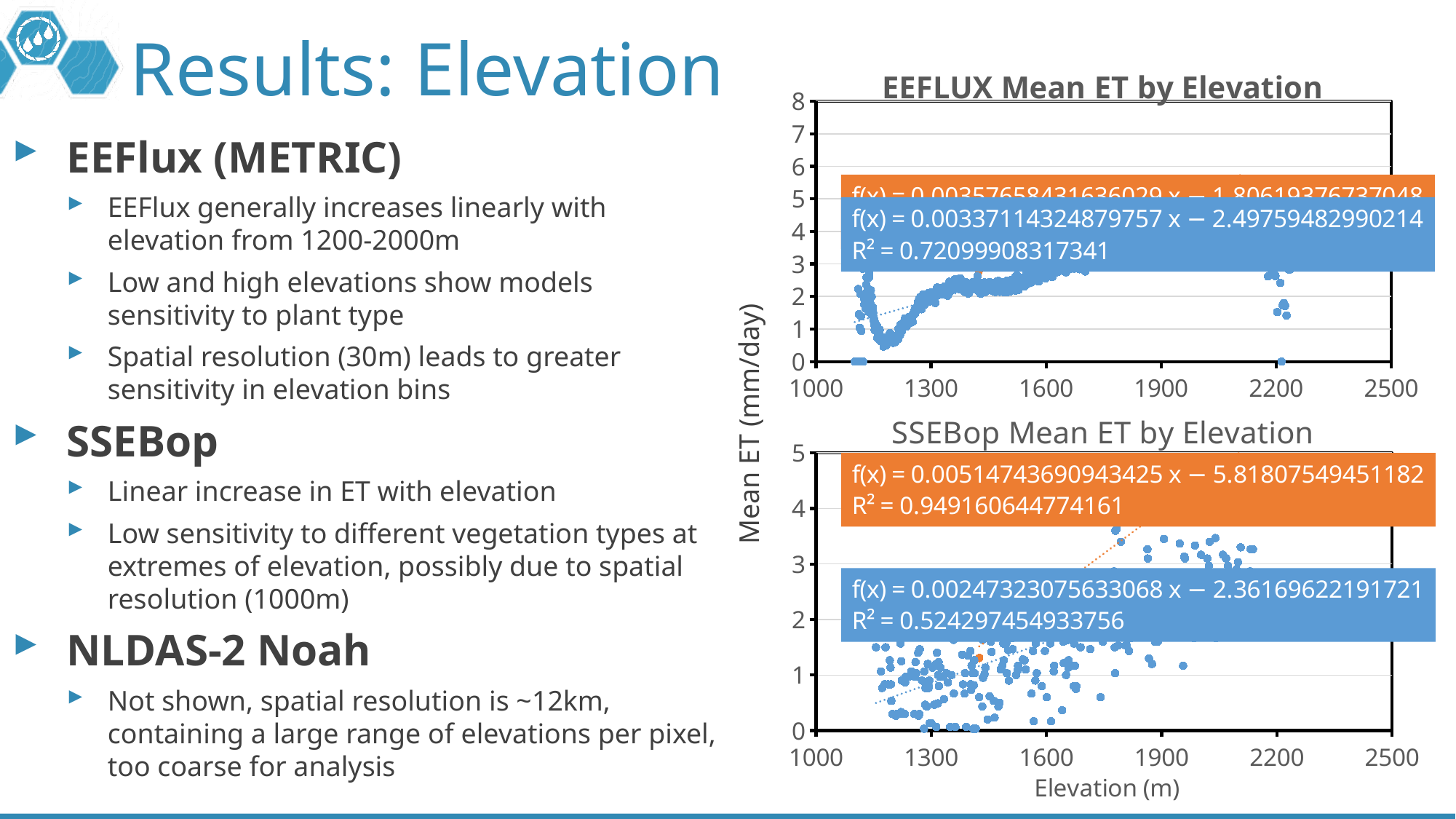
In the EEFLUX Mean ET by Elevation chart, what is the maximum value shown on the y-axis? 8 In the SSEBop Mean ET by Elevation chart, are the points plotted around 1900 m elevation greater or less than 2 mm/day? greater What kind of chart is the EEFLUX Mean ET by Elevation chart? Scatter chart In the EEFLUX Mean ET by Elevation chart, what is the R² value shown in the blue box? 0.72099908317341 What is the title of the lower chart on the slide? SSEBop Mean ET by Elevation In the SSEBop Mean ET by Elevation chart, what is the R² value shown in the blue box? 0.524297454933756 In the SSEBop Mean ET by Elevation chart, what is the slope of the trendline in the orange box? 0.00514743690943425 What is the x-axis label shared by the two charts? Elevation (m) In the SSEBop Mean ET by Elevation chart, do the mean ET values generally rise or fall as elevation increases? Rise In the SSEBop Mean ET by Elevation chart, what is the R² value shown in the orange box? 0.949160644774161 In the EEFLUX Mean ET by Elevation chart, are the lowest points near 1200 m elevation greater or less than 1 mm/day? less In the SSEBop Mean ET by Elevation chart, which trendline has the higher R², the orange one or the blue one? Orange